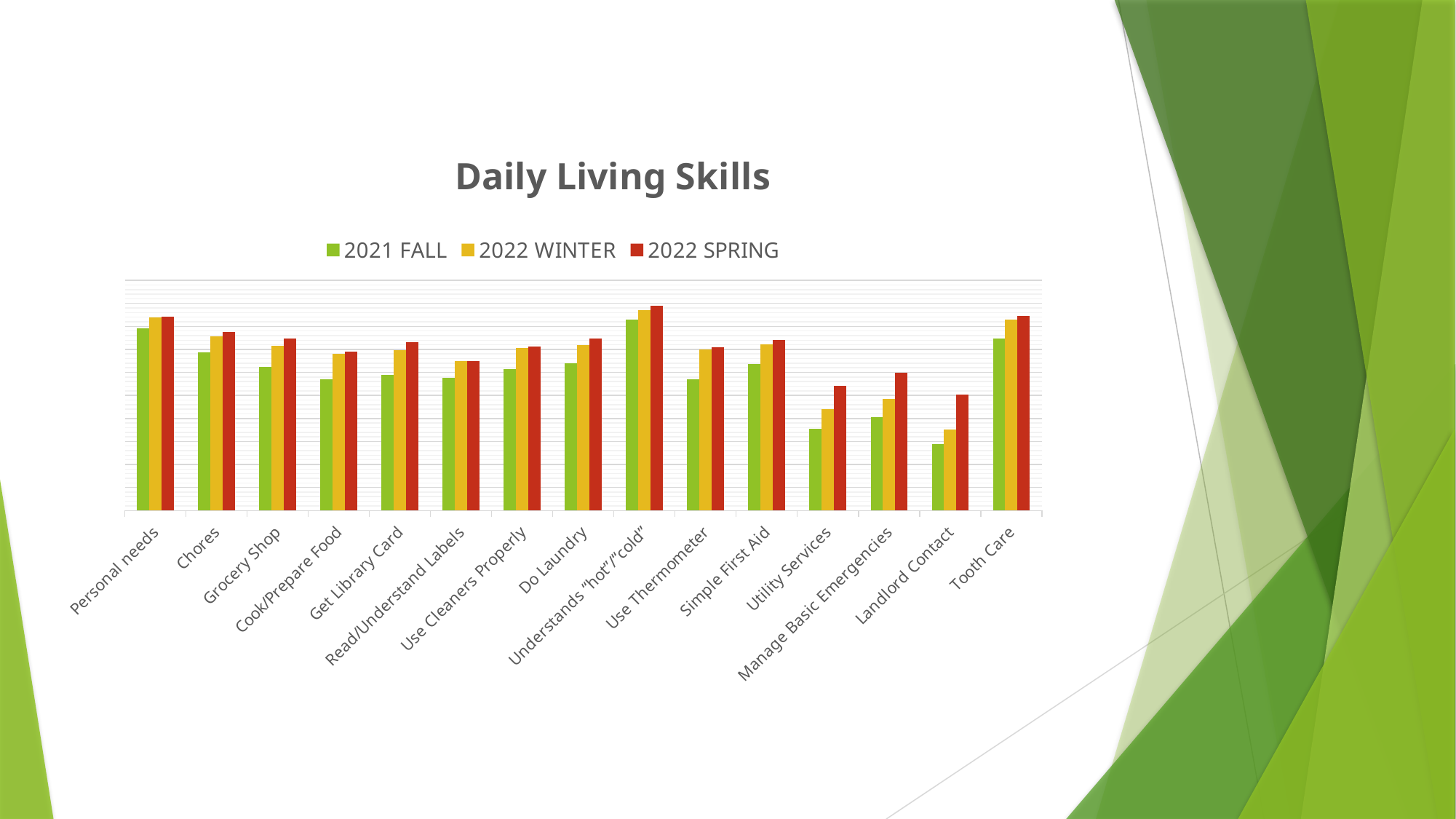
For Utility Services, do the values rise or fall from 2021 FALL to 2022 WINTER to 2022 SPRING? Rise Which category has the lowest 2021 FALL value? Landlord Contact Which is larger for 2022 SPRING: Tooth Care or Utility Services? Tooth Care Which is larger for 2021 FALL: Personal needs or Chores? Personal needs Which category has the highest 2021 FALL value? Understands "hot"/"cold" What type of chart is shown on the slide? Bar chart What are the three series named in the legend? 2021 FALL, 2022 WINTER, 2022 SPRING Which category has the highest 2022 SPRING value? Understands "hot"/"cold" How many skill categories are shown on the x axis? 15 What is the title of the chart? Daily Living Skills Which category has the lowest 2022 WINTER value? Landlord Contact How many series does the legend list? 3